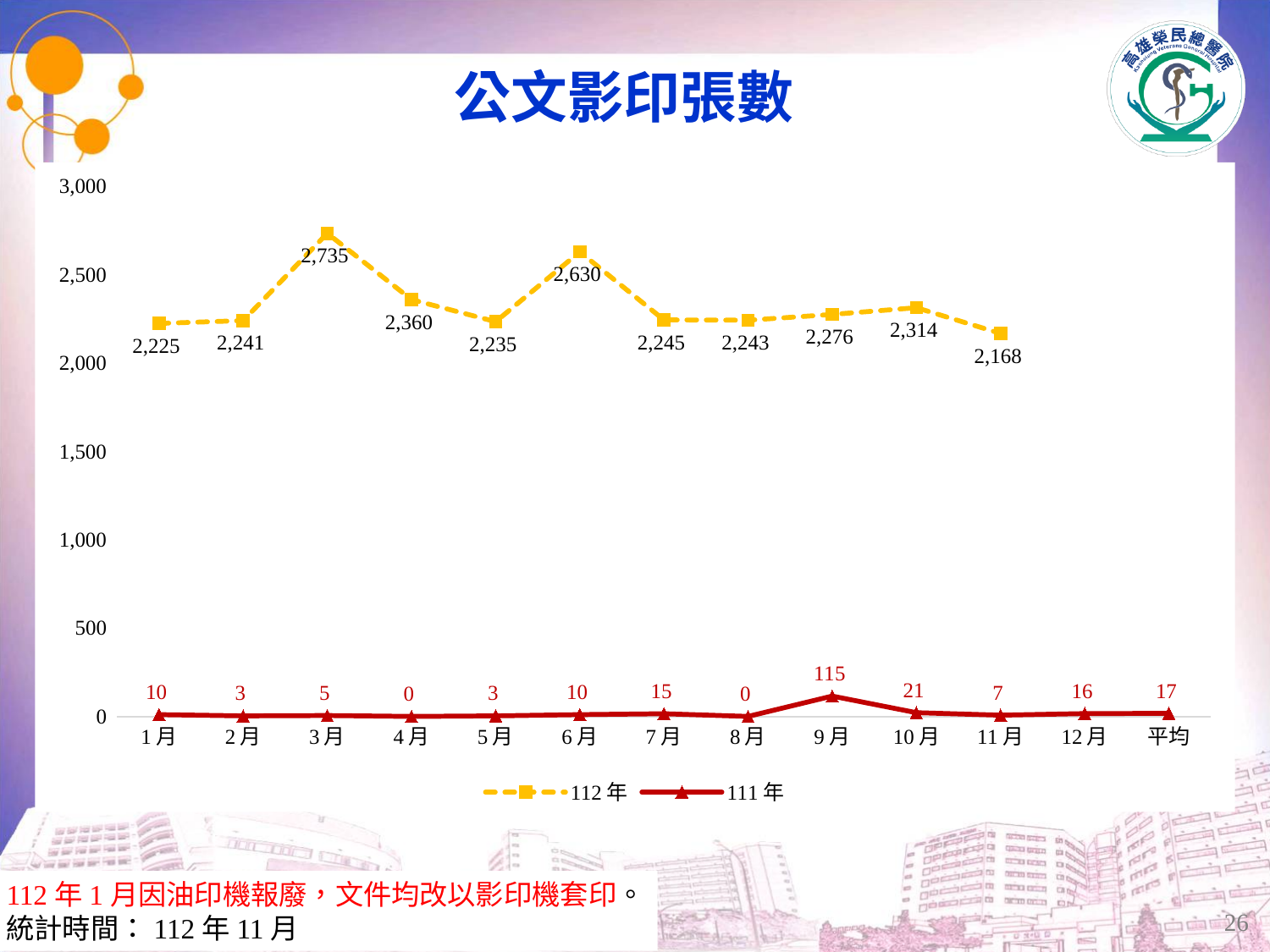
What is the value for 111年 in 9月? 115 What is the value for 112年 in 3月? 2,735 Which is larger, the 112年 value for 6月 or for 10月? 6月 What is the value for 112年 in 11月? 2,168 In which month is the 112年 value lowest? 11月 How many series does the legend list? 2 What kind of chart is shown on the slide? line chart What is the title of the chart? 公文影印張數 What is the 平均 value for 111年? 17 How many categories are shown on the x axis? 13 What is the difference between the 112年 values for 3月 and 4月? 375 In which month is the 112年 value highest? 3月